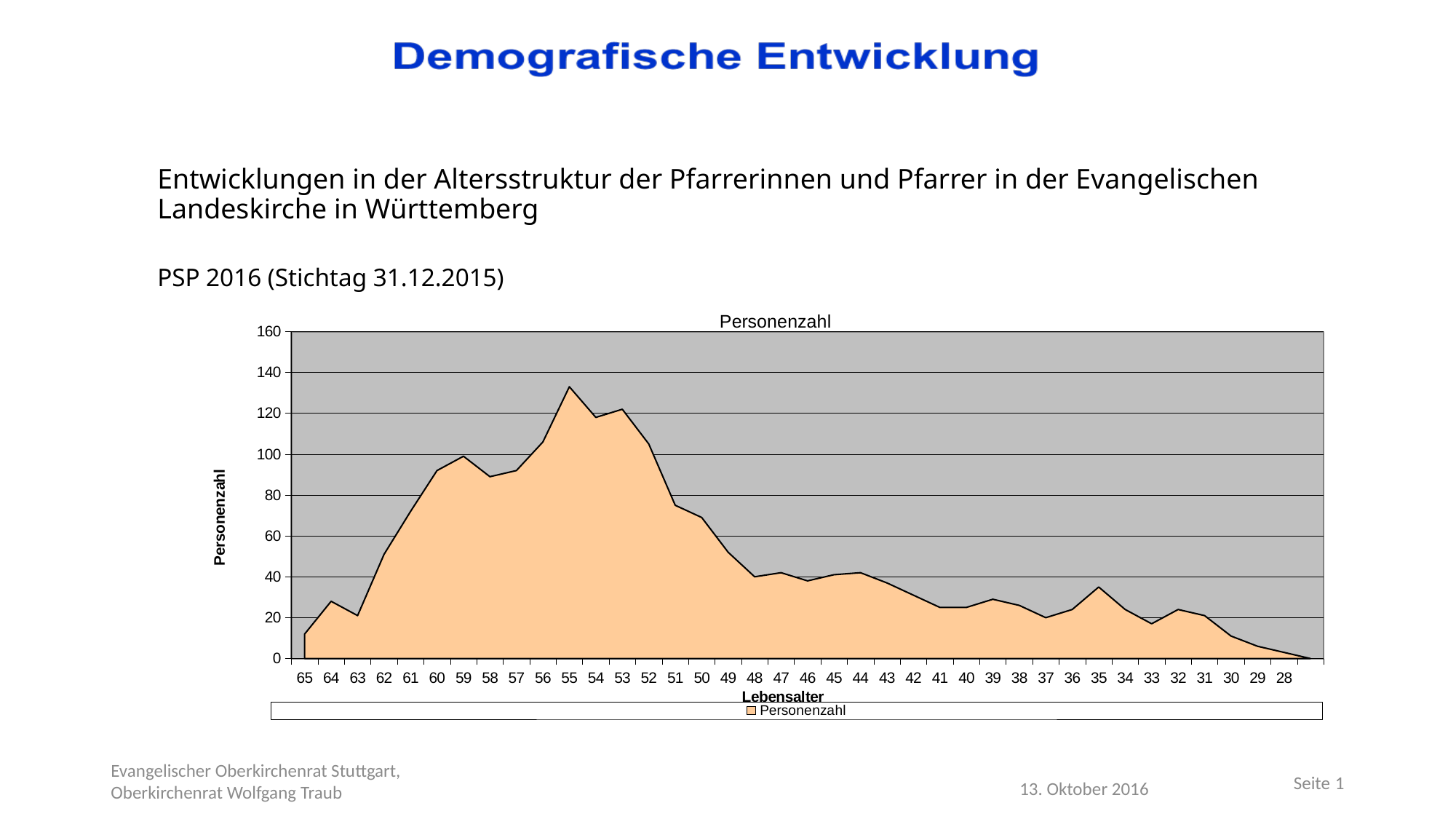
Do the values generally rise or fall along the x axis from age 55 to age 28? fall Is the Personenzahl for age 37 greater or less than 40? less Is the Personenzahl for age 65 greater or less than 20? less At which age (Lebensalter) is the Personenzahl highest? 55 What kind of chart is shown on the slide? area chart Is the Personenzahl for age 48 greater or less than 60? less What is the title of the x axis of the chart? Lebensalter Which age has the larger Personenzahl, 60 or 40? 60 How many series does the chart legend list? 1 How many age categories are shown on the x axis of the chart? 38 At which age (Lebensalter) is the Personenzahl lowest? 28